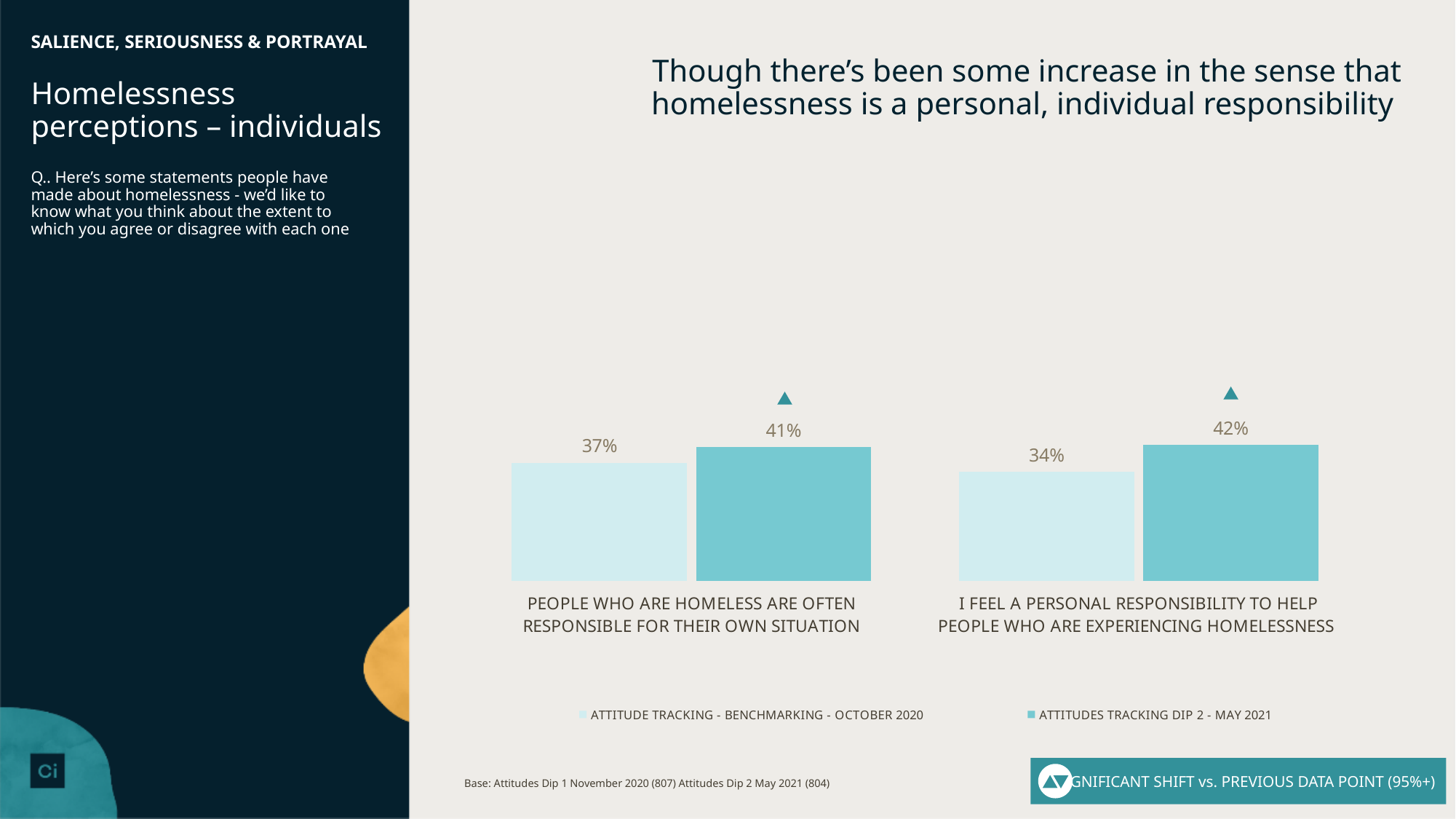
How many statements (categories) are shown on the chart? 2 How many series does the legend list? 2 For the statement 'People who are homeless are often responsible for their own situation', which wave had the larger value, October 2020 or May 2021? May 2021 What percentage said they feel a personal responsibility to help people who are experiencing homelessness in the October 2020 wave? 34% What percentage agreed that people who are homeless are often responsible for their own situation in the Attitude Tracking - Benchmarking - October 2020 wave? 37% By how many percentage points did agreement with 'People who are homeless are often responsible for their own situation' change from October 2020 to May 2021? 4 percentage points Which statement had the higher agreement in the May 2021 wave? I feel a personal responsibility to help people who are experiencing homelessness What type of chart is shown on the slide? Bar chart What percentage said they feel a personal responsibility to help people who are experiencing homelessness in the May 2021 wave? 42% By how many percentage points did agreement with 'I feel a personal responsibility to help people who are experiencing homelessness' change from October 2020 to May 2021? 8 percentage points Which statement had the lower agreement in the October 2020 wave? I feel a personal responsibility to help people who are experiencing homelessness What percentage agreed that people who are homeless are often responsible for their own situation in the Attitudes Tracking Dip 2 - May 2021 wave? 41%